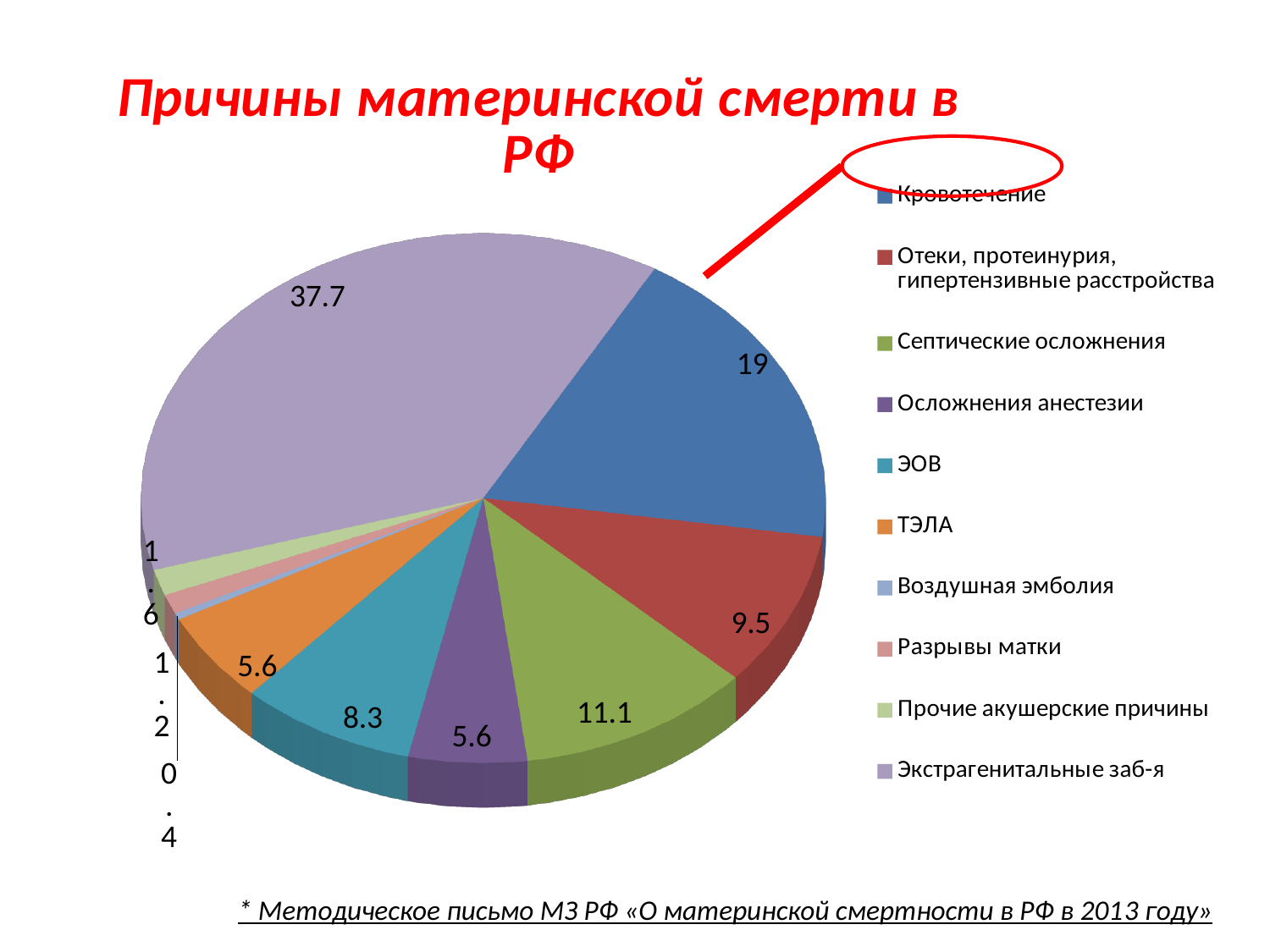
What value is shown for Септические осложнения? 11.1 How many categories does the legend list? 10 Which is larger, the value for Кровотечение or for Септические осложнения? Кровотечение What kind of chart is shown on the slide? Pie chart Which category has the largest slice of the pie? Экстрагенитальные заб-я Which is larger, the value for ЭОВ or for ТЭЛА? ЭОВ What value is shown for ЭОВ? 8.3 What value is shown for Отеки, протеинурия, гипертензивные расстройства? 9.5 What value is shown for Экстрагенитальные заб-я? 37.7 What is the difference between the values for Экстрагенитальные заб-я and Кровотечение? 18.7 What value is shown for Кровотечение? 19 What is the title of the slide? Причины материнской смерти в РФ